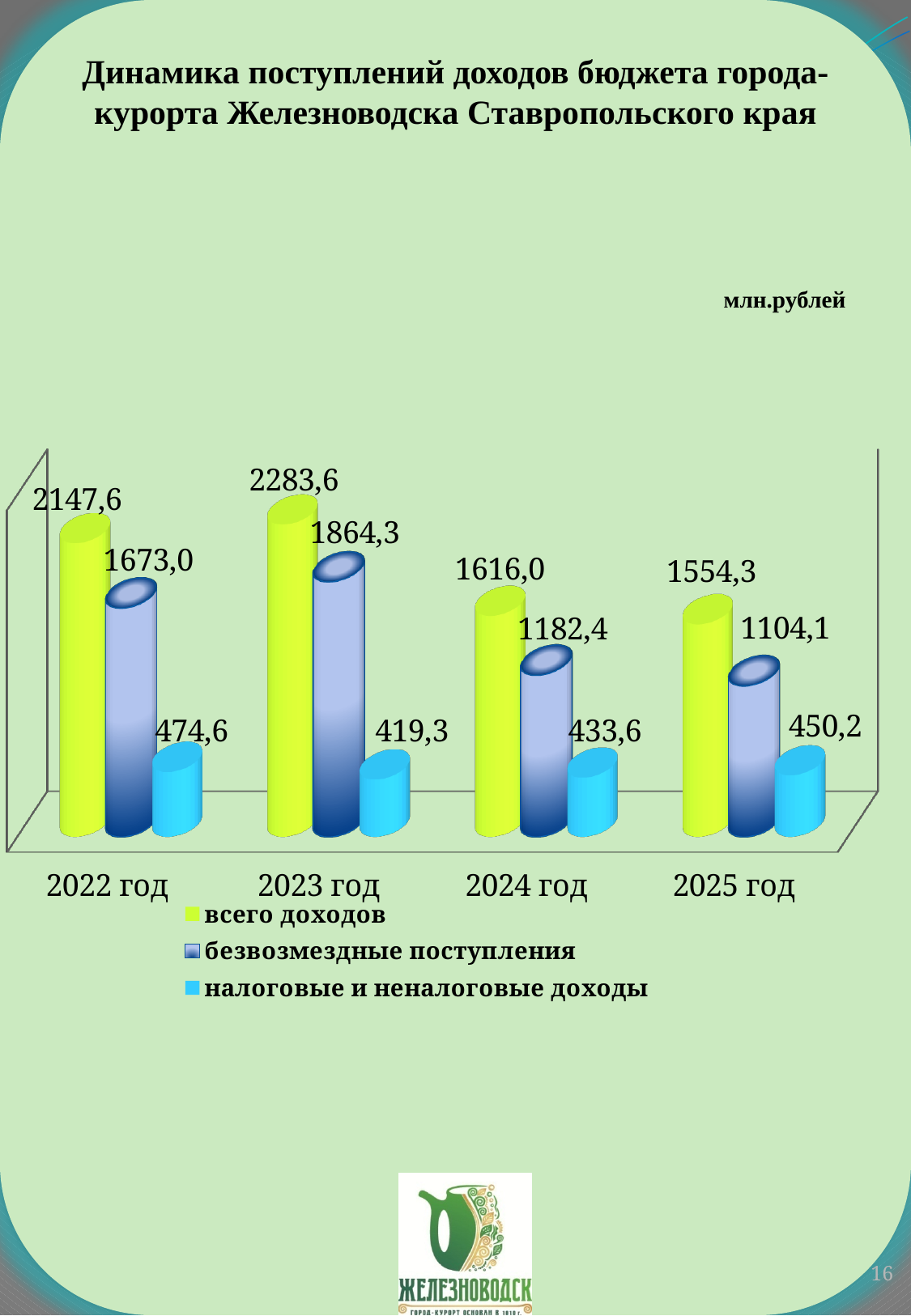
What is the value of всего доходов for 2023 год? 2283,6 In which year is всего доходов the highest? 2023 год What kind of chart is shown on the slide? bar chart How many series does the legend list? 3 Does всего доходов rise or fall from 2023 год to 2025 год? fall In which year is налоговые и неналоговые доходы the lowest? 2023 год How many years are shown on the x axis? 4 What is the value of безвозмездные поступления for 2025 год? 1104,1 What is the difference between всего доходов in 2023 год and in 2022 год? 136,0 What is the value of налоговые и неналоговые доходы for 2024 год? 433,6 Which is larger: безвозмездные поступления in 2024 год or in 2025 год? 2024 год What is the difference between налоговые и неналоговые доходы in 2022 год and in 2023 год? 55,3